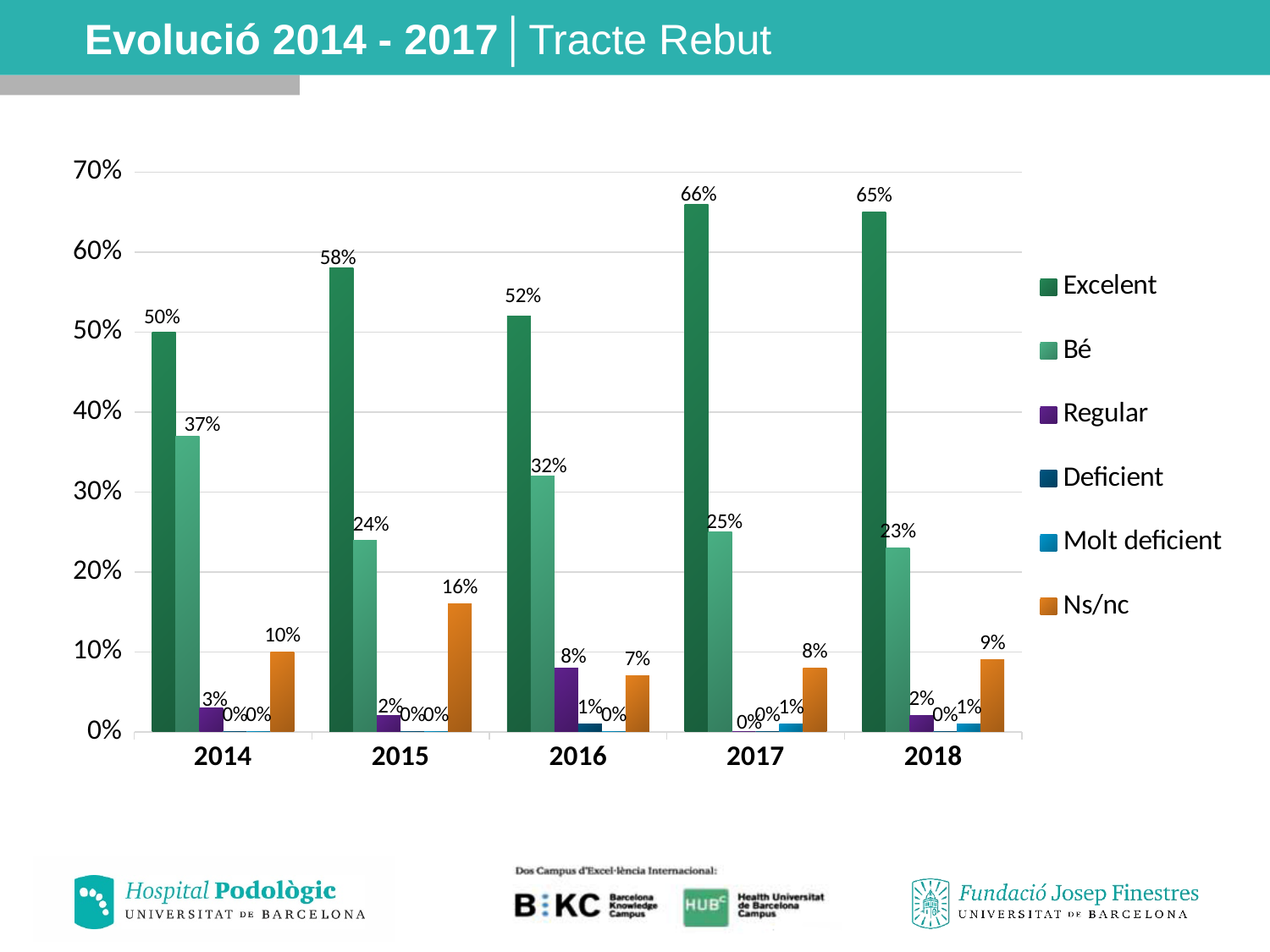
What is the difference between the Excelent values for 2015 and 2014? 8% What is the value for Excelent in 2017? 66% What is the value for Ns/nc in 2015? 16% How many years are shown on the x axis? 5 How many series does the legend list? 6 In which year is the Bé value lowest? 2018 What type of chart is shown on the slide? bar chart What is the value for Regular in 2016? 8% Does the Bé value rise or fall from 2016 to 2018? fall In which year is the Excelent value highest? 2017 Which is larger, the Ns/nc value in 2016 or in 2018? 2018 What is the value for Bé in 2014? 37%